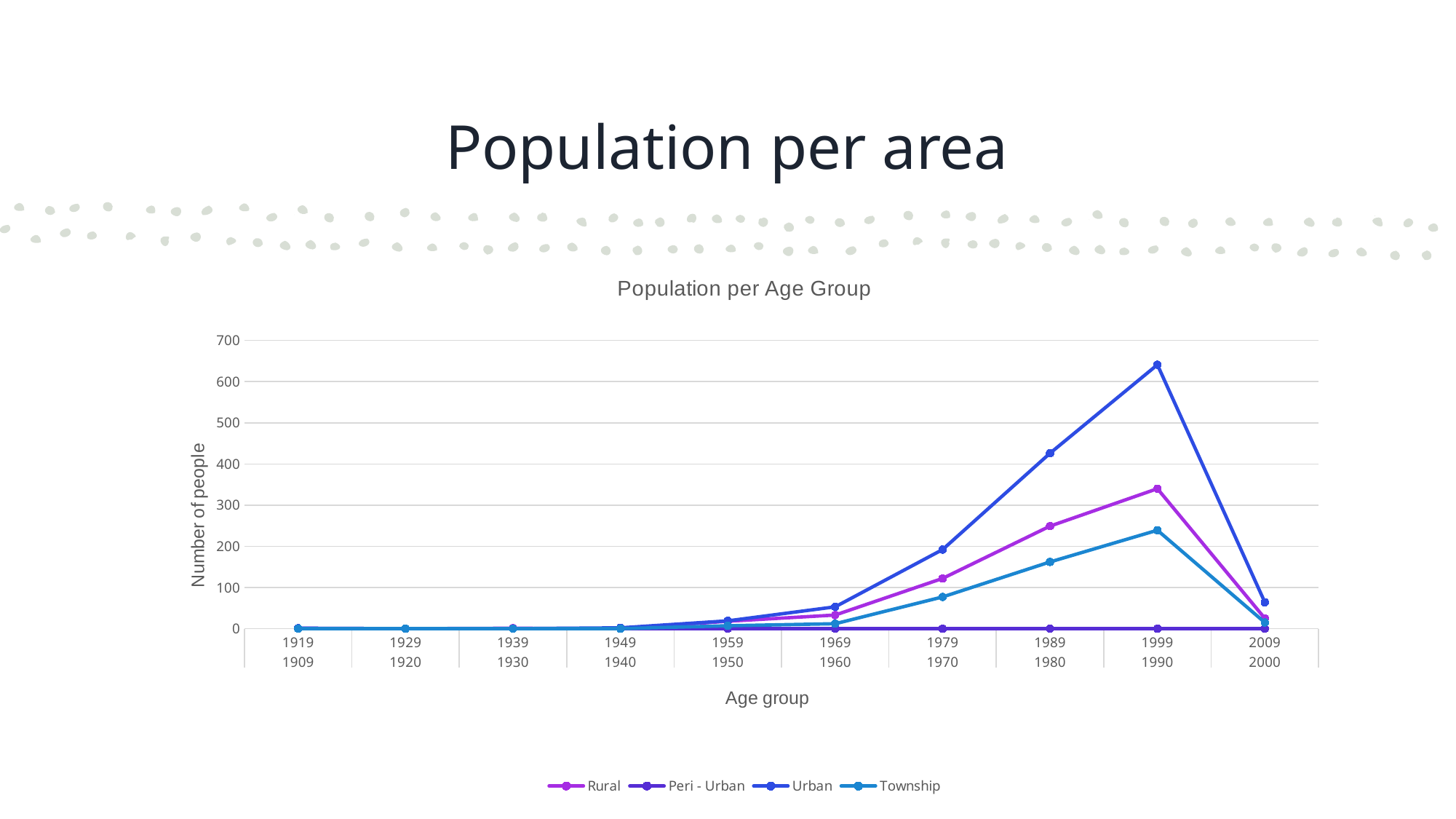
Which series has the highest value at the 1999 / 1990 age group? Urban Is the Urban value for the 1999 / 1990 age group greater or less than 600? greater How many series does the legend list? 4 Which series has the lowest value at the 1999 / 1990 age group? Peri - Urban How many age-group categories are shown on the x axis? 10 What is the title of the chart? Population per Age Group At the 1989 / 1980 age group, which is larger, the Rural value or the Township value? Rural What kind of chart is shown on the slide? line chart Is the Urban value for the 1989 / 1980 age group greater or less than 400? greater Is the Township value for the 1999 / 1990 age group greater or less than 200? greater Does the Urban line rise or fall between the 1999 / 1990 and 2009 / 2000 age groups? fall